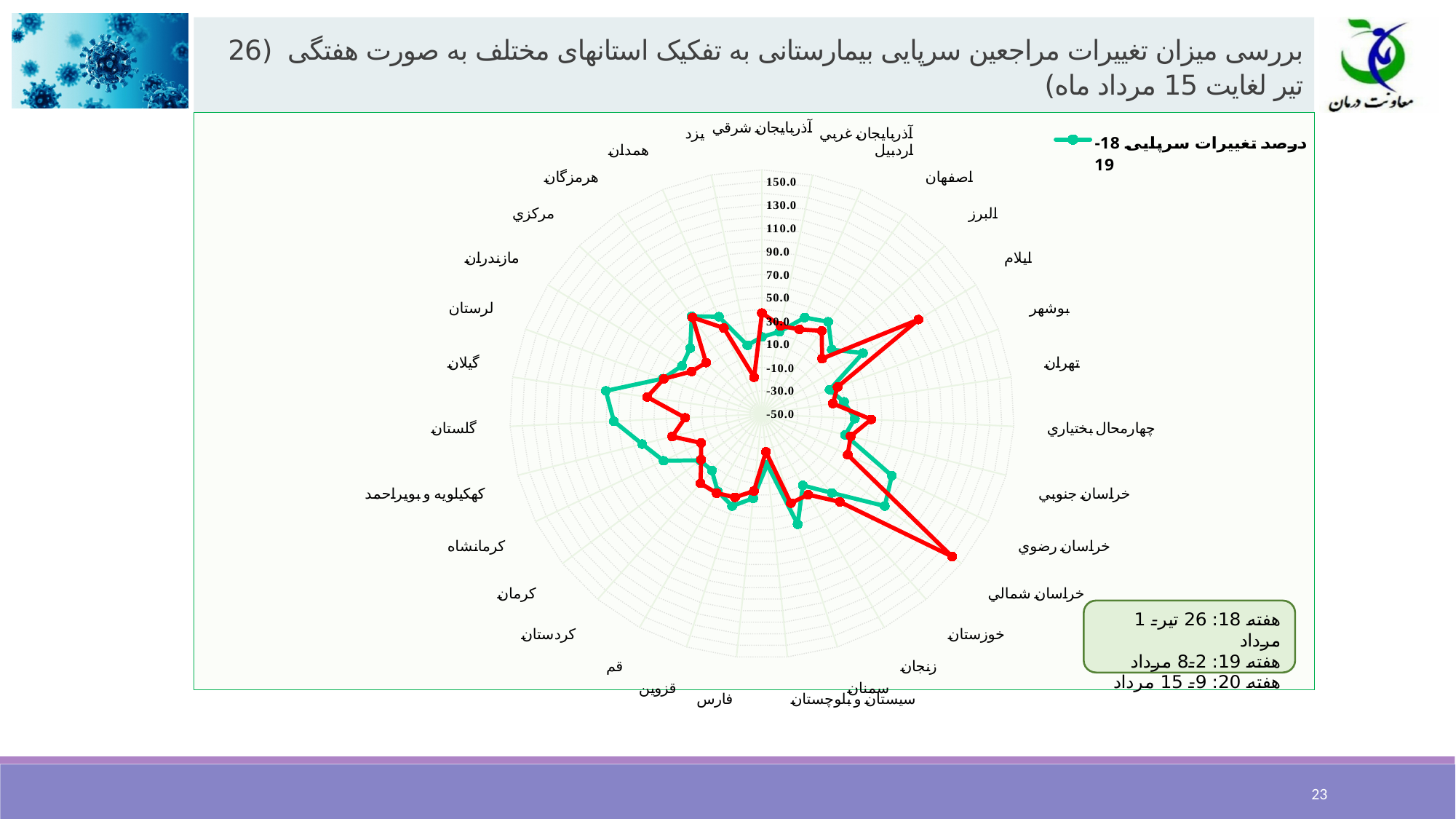
What is the highest value shown on the radar chart's axis? 150.0 Which series, red or green, reaches the point farthest from the centre of the radar chart? red Is the value of the green series for گيلان greater or less than 50? greater What kind of chart is shown on the slide? radar chart What is the lowest value shown on the radar chart's axis? -50.0 Is the highest value reached by the red series greater or less than 130? greater How many provinces (categories) are plotted around the radar chart? 31 How many data series (lines) are plotted on the radar chart? 2 Is the value of the green series for گيلان greater or less than the value of the green series for تهران? greater